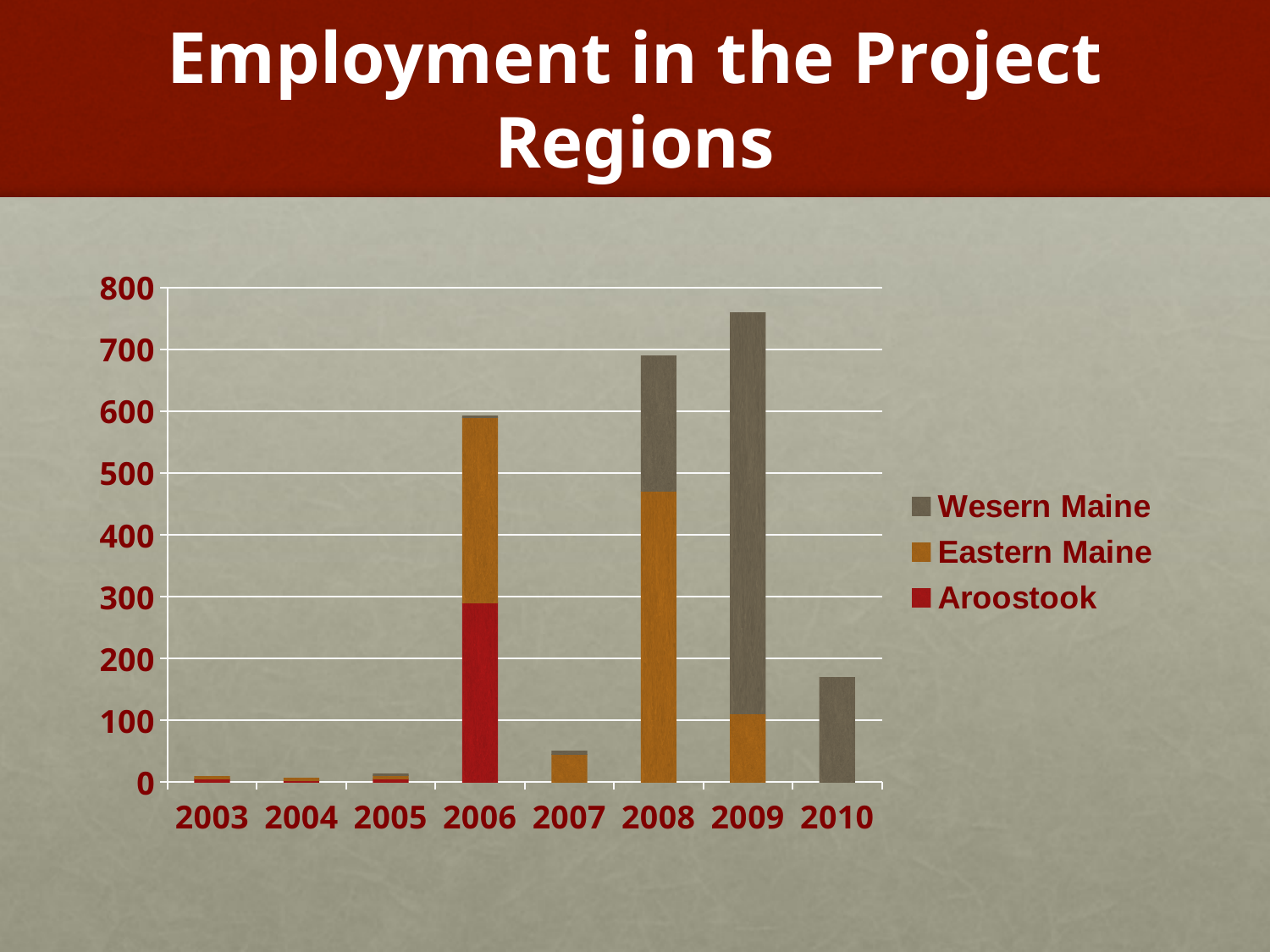
Is the value for 2007 greater or less than 100? less Which year has the highest total employment bar? 2009 How many years are shown on the x axis? 8 Is the value for 2010 greater or less than 200? less What kind of chart is shown on the slide? Stacked bar chart Which series is shown in red in the legend? Aroostook Which year has the larger total bar, 2006 or 2008? 2008 How many series does the legend list? 3 Which year has the larger total bar, 2008 or 2009? 2009 Is the total bar for 2009 greater or less than 700? greater What is the title of the chart? Employment in the Project Regions